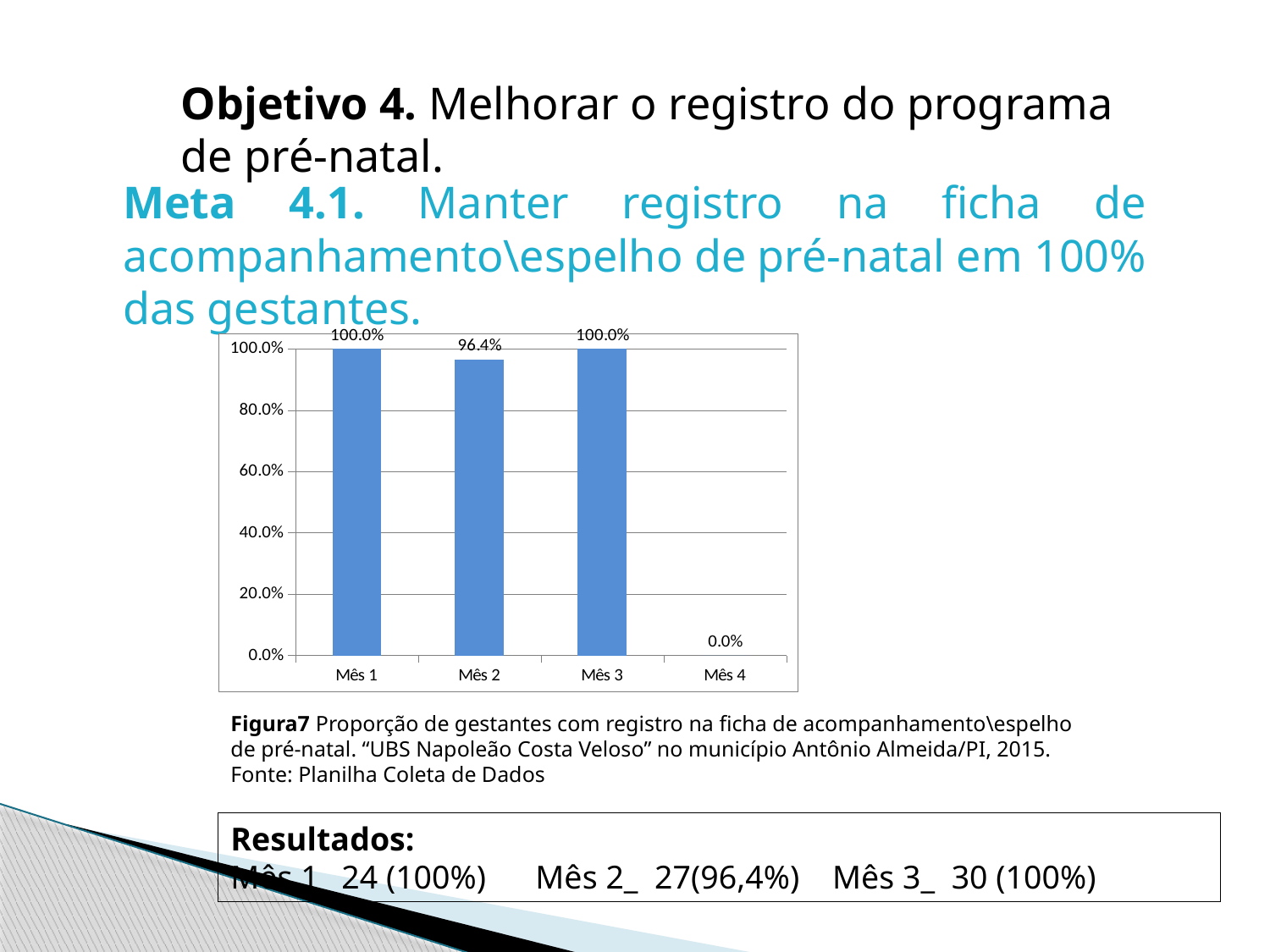
Is the value for Mês 2 greater or less than 80.0%? greater Do the values rise or fall from Mês 3 to Mês 4? fall Which is larger, the value for Mês 2 or the value for Mês 3? Mês 3 What colour are the bars in the chart? blue How many months are shown on the x axis? 4 What is the value for Mês 4? 0.0% What is the difference between the values for Mês 1 and Mês 2? 3.6% What is the value for Mês 1? 100.0% Which month has the lowest value? Mês 4 What kind of chart is shown on the slide? bar chart What is the value for Mês 2? 96.4% What is the highest value shown on the y axis? 100.0%